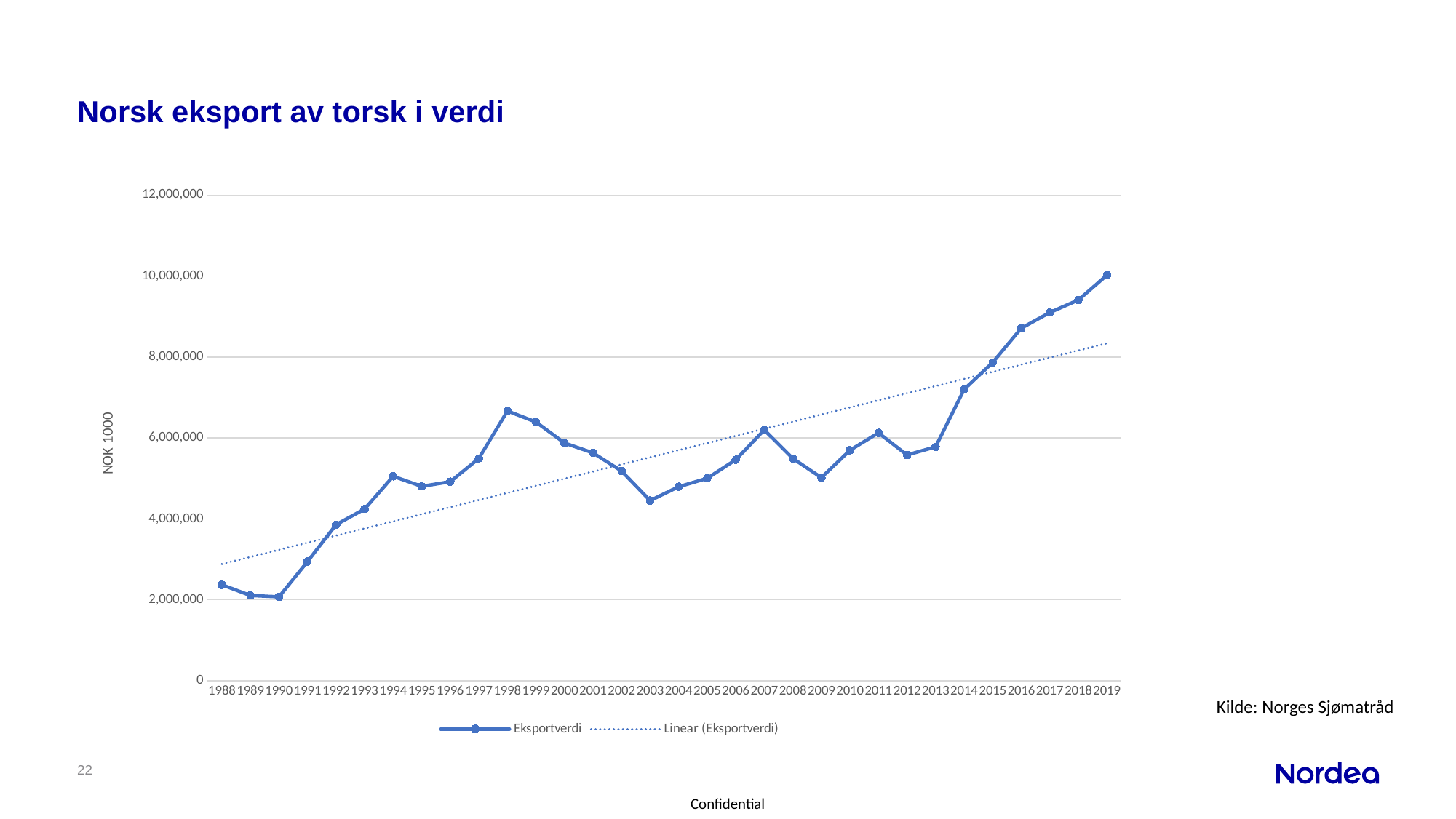
Which year has the larger export value, 1998 or 2003? 1998 Which year has the highest export value (Eksportverdi)? 2019 Is the value for 1998 greater or less than 6,000,000? greater Is the value for 1991 greater or less than 4,000,000? less Is the value for 2016 greater or less than 8,000,000? greater What is the label on the y axis? NOK 1000 How many years are plotted along the x axis? 32 How many series does the legend list? 2 Overall, do the export values rise or fall from 1988 to 2019? rise What kind of chart is shown on the slide? line chart